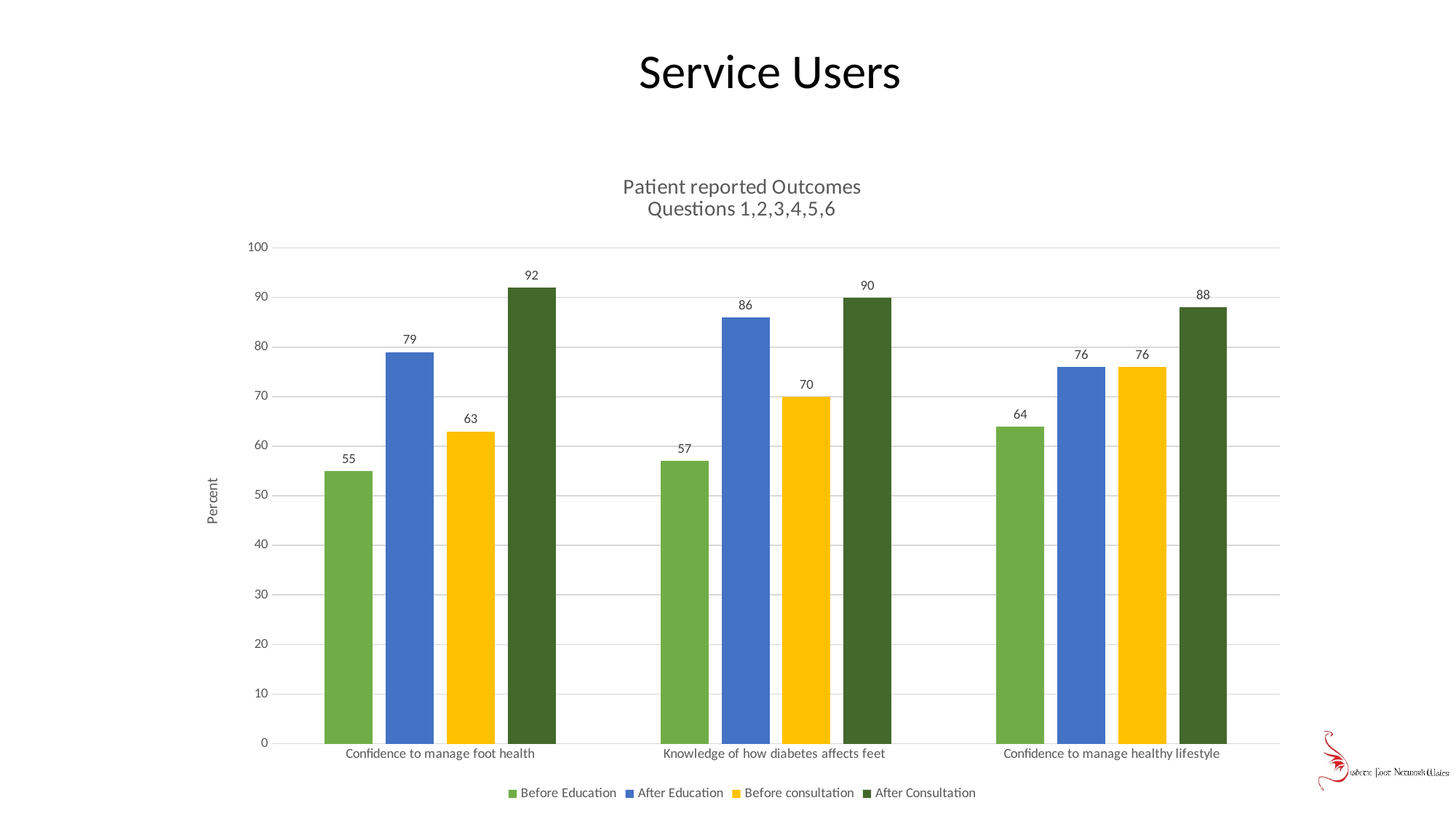
What is the value for Before consultation in the Confidence to manage healthy lifestyle category? 76 How many series does the legend list? 4 Is the value for Before consultation in the Confidence to manage foot health category greater or less than 70? less What is the label on the vertical axis? Percent What is the value for Before Education in the Confidence to manage foot health category? 55 What kind of chart is shown on the slide? bar chart Which is larger: After Education for Knowledge of how diabetes affects feet or After Education for Confidence to manage healthy lifestyle? Knowledge of how diabetes affects feet Which series has the lowest value in the Knowledge of how diabetes affects feet category? Before Education What is the difference between After Education and Before Education in the Confidence to manage foot health category? 24 Which series has the highest value in the Confidence to manage foot health category? After Consultation What is the value for After Consultation in the Knowledge of how diabetes affects feet category? 90 How many categories are shown on the x axis? 3